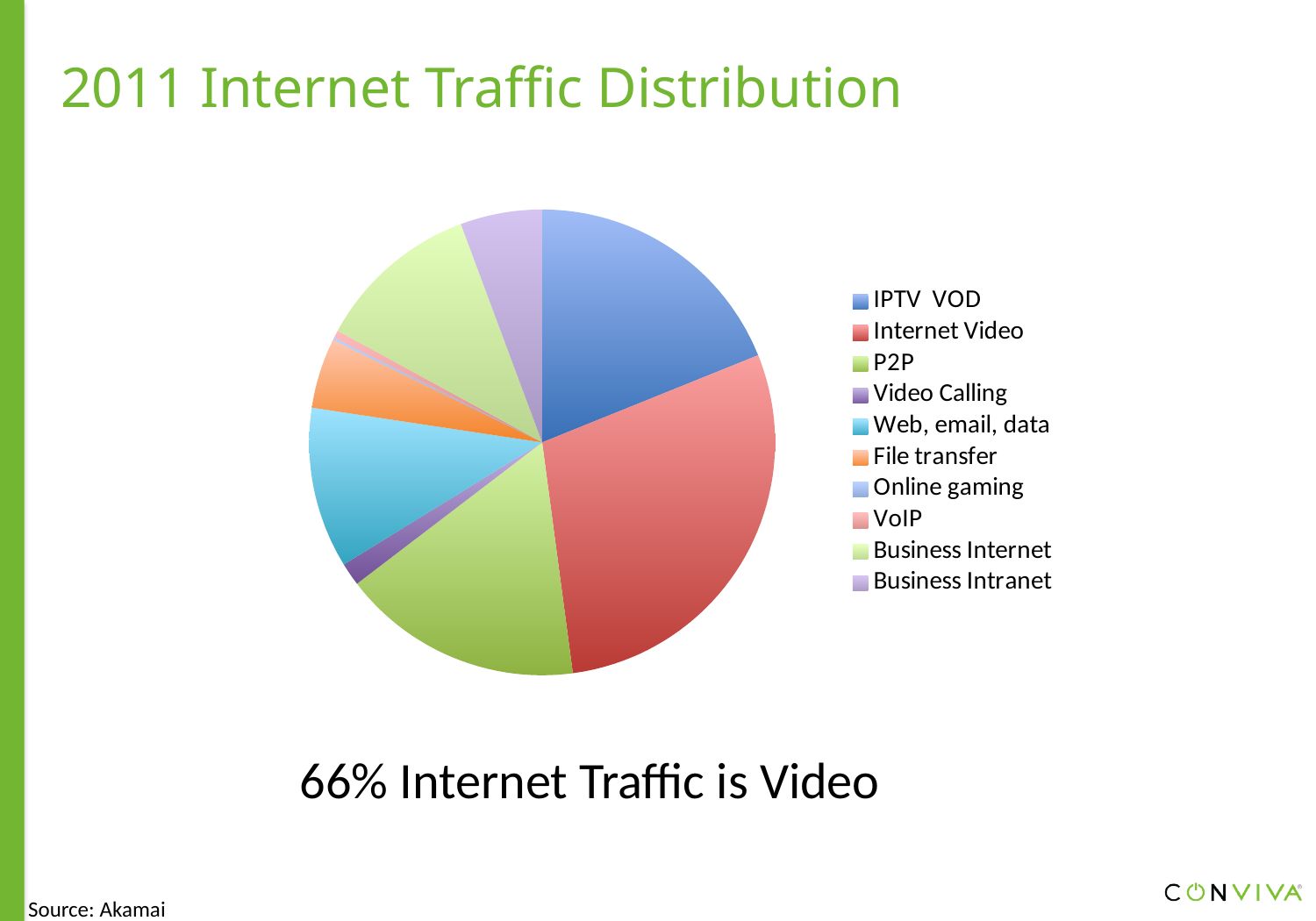
What is the title of the slide containing the pie chart? 2011 Internet Traffic Distribution How many categories does the pie chart's legend list? 10 Which slice is larger, File transfer or Video Calling? File transfer What kind of chart is shown on the slide? pie chart What colour is the Internet Video slice in the pie chart? red Which slice is larger, IPTV VOD or Business Intranet? IPTV VOD Which category has the largest slice of the pie chart? Internet Video Which slice is larger, P2P or Web, email, data? P2P